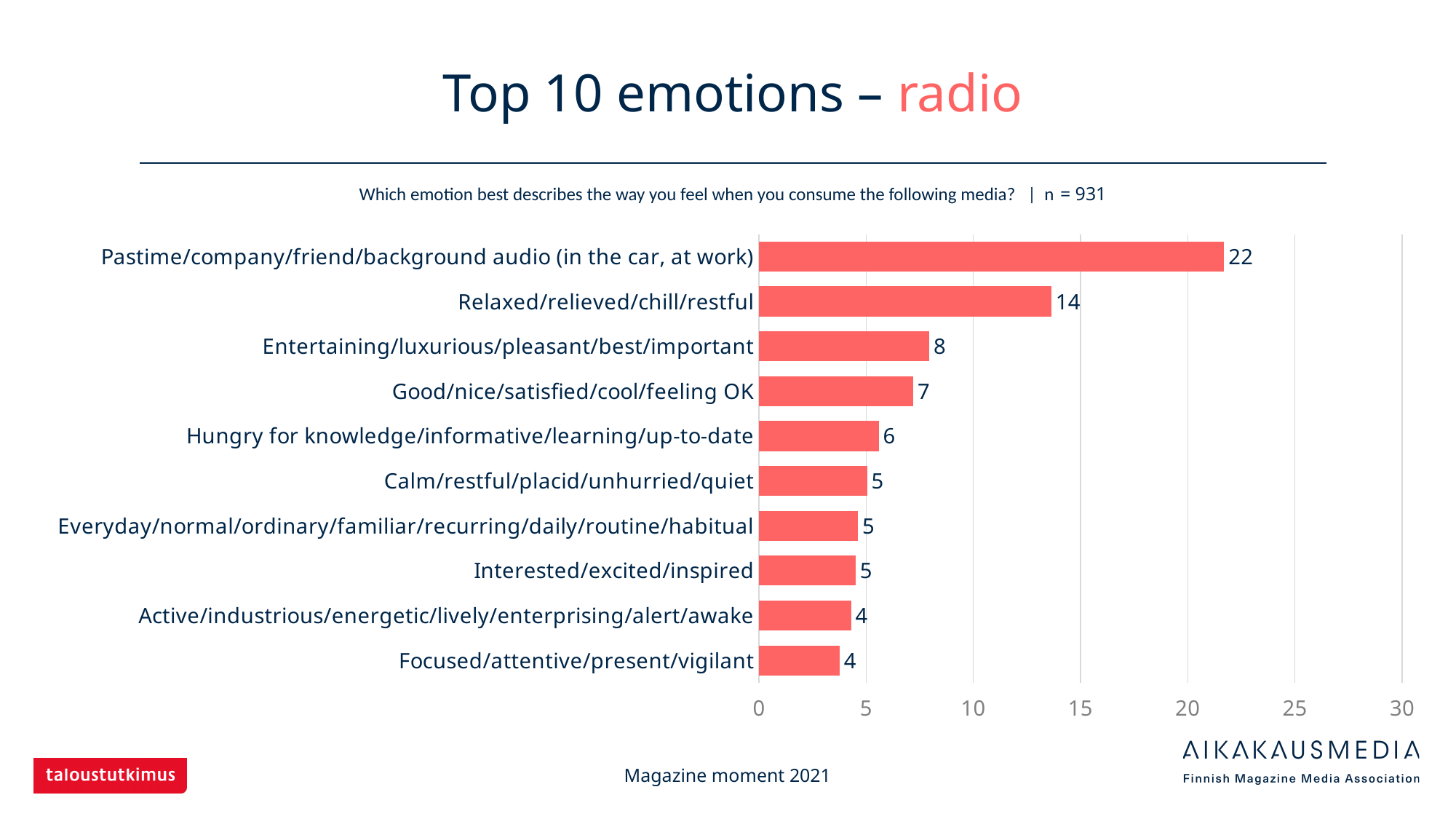
Which has a larger value, Entertaining/luxurious/pleasant/best/important or Calm/restful/placid/unhurried/quiet? Entertaining/luxurious/pleasant/best/important What is the value for Hungry for knowledge/informative/learning/up-to-date? 6 How many emotion categories are shown in the chart? 10 What is the sample size (n) stated on the slide? 931 What is the difference between the values for Pastime/company/friend/background audio (in the car, at work) and Relaxed/relieved/chill/restful? 8 What is the title of the slide? Top 10 emotions – radio What kind of chart is shown on the slide? bar chart What is the value for Good/nice/satisfied/cool/feeling OK? 7 What is the value for Focused/attentive/present/vigilant? 4 What is the value for Relaxed/relieved/chill/restful? 14 Which emotion category has the highest value? Pastime/company/friend/background audio (in the car, at work) Is the value for Pastime/company/friend/background audio (in the car, at work) greater or less than 20? greater